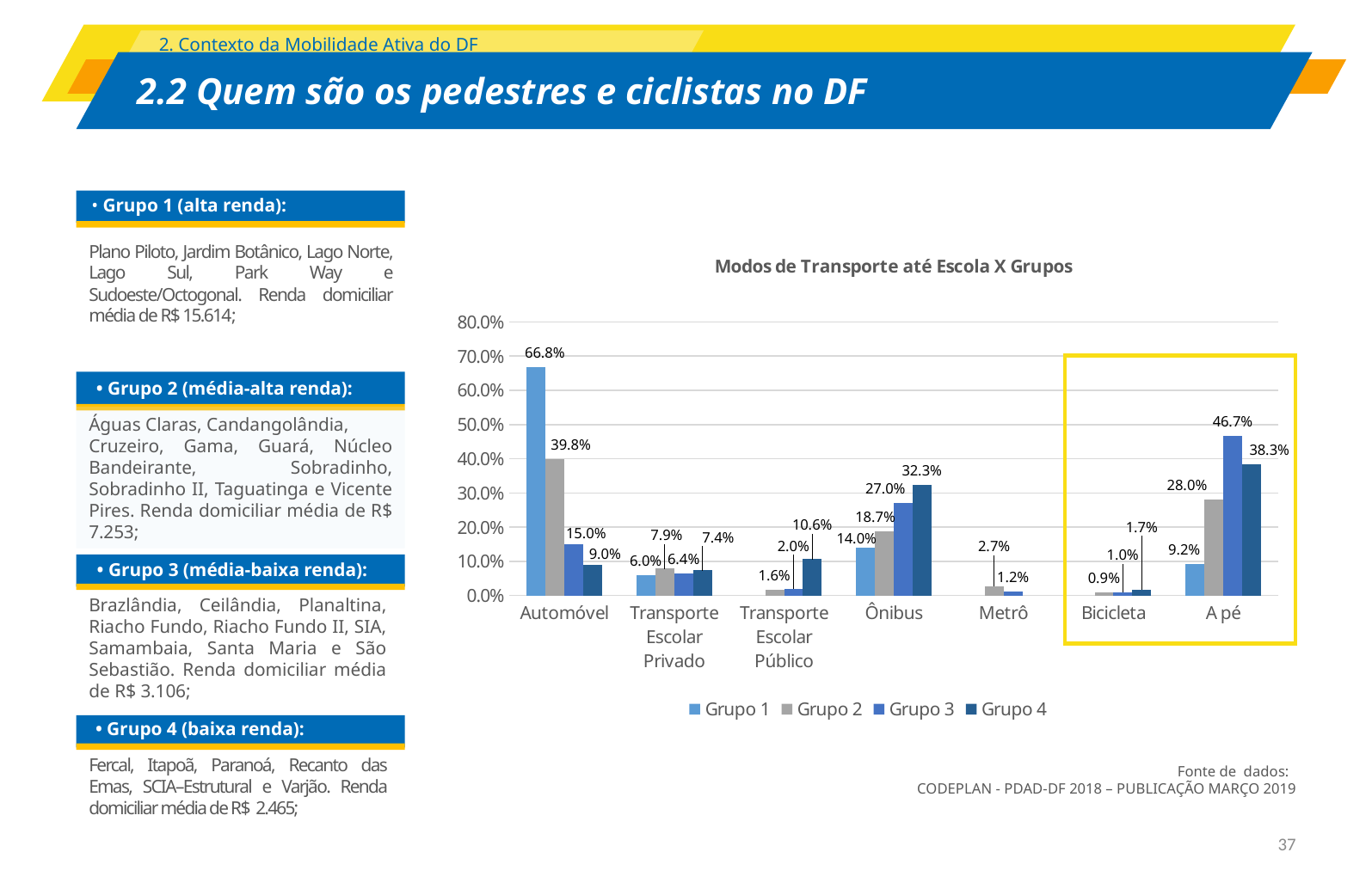
What kind of chart is shown on the slide? Bar chart In the Ônibus category, which is larger: Grupo 3 or Grupo 4? Grupo 4 What is the value for Grupo 2 in the Transporte Escolar Privado category? 7.9% What is the value for Grupo 3 in the A pé category? 46.7% Which group has the lowest value in the A pé category? Grupo 1 How many series does the legend list? 4 How many transport mode categories are shown on the x axis? 7 What is the value for Grupo 1 in the Automóvel category? 66.8% Is the value for Grupo 4 in the A pé category greater or less than 40%? less What is the difference between Grupo 1 and Grupo 2 in the Automóvel category? 27.0 percentage points What is the value for Grupo 4 in the Ônibus category? 32.3% Which group has the highest value in the Automóvel category? Grupo 1